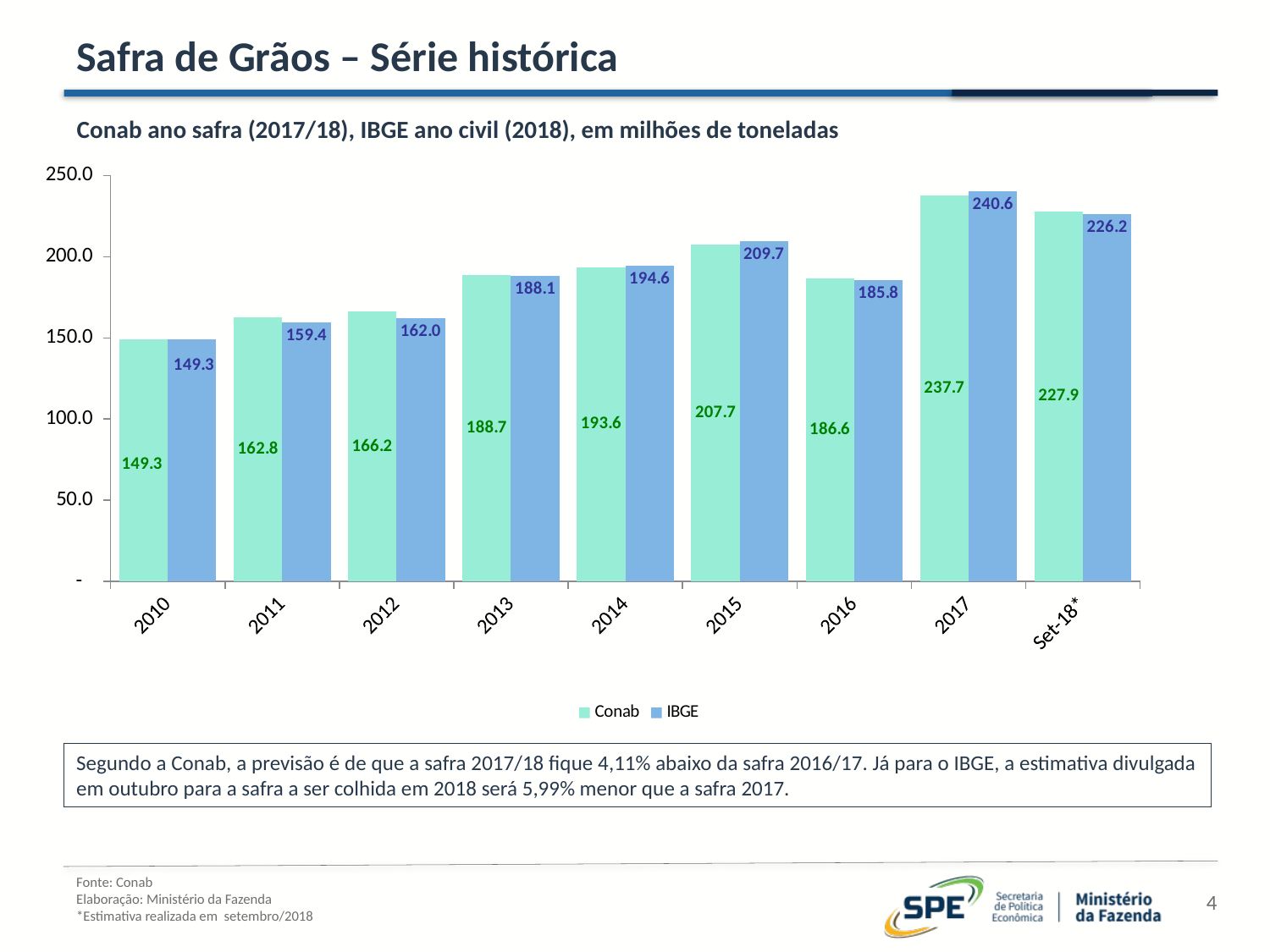
Which year has the highest IBGE value? 2017 What kind of chart is shown on the slide? bar chart What is the IBGE value for 2017? 240.6 Which series is shown in dark blue in the legend? IBGE What is the Conab value for 2015? 207.7 How many categories are shown on the x axis? 9 Which category has the lowest Conab value? 2010 What is the Conab value for Set-18*? 227.9 How many series does the legend list? 2 Which is larger, the IBGE value for 2014 or the IBGE value for 2013? 2014 What is the difference between the Conab values for 2017 and 2016? 51.1 Is the Conab value for 2012 greater or less than 150.0? greater